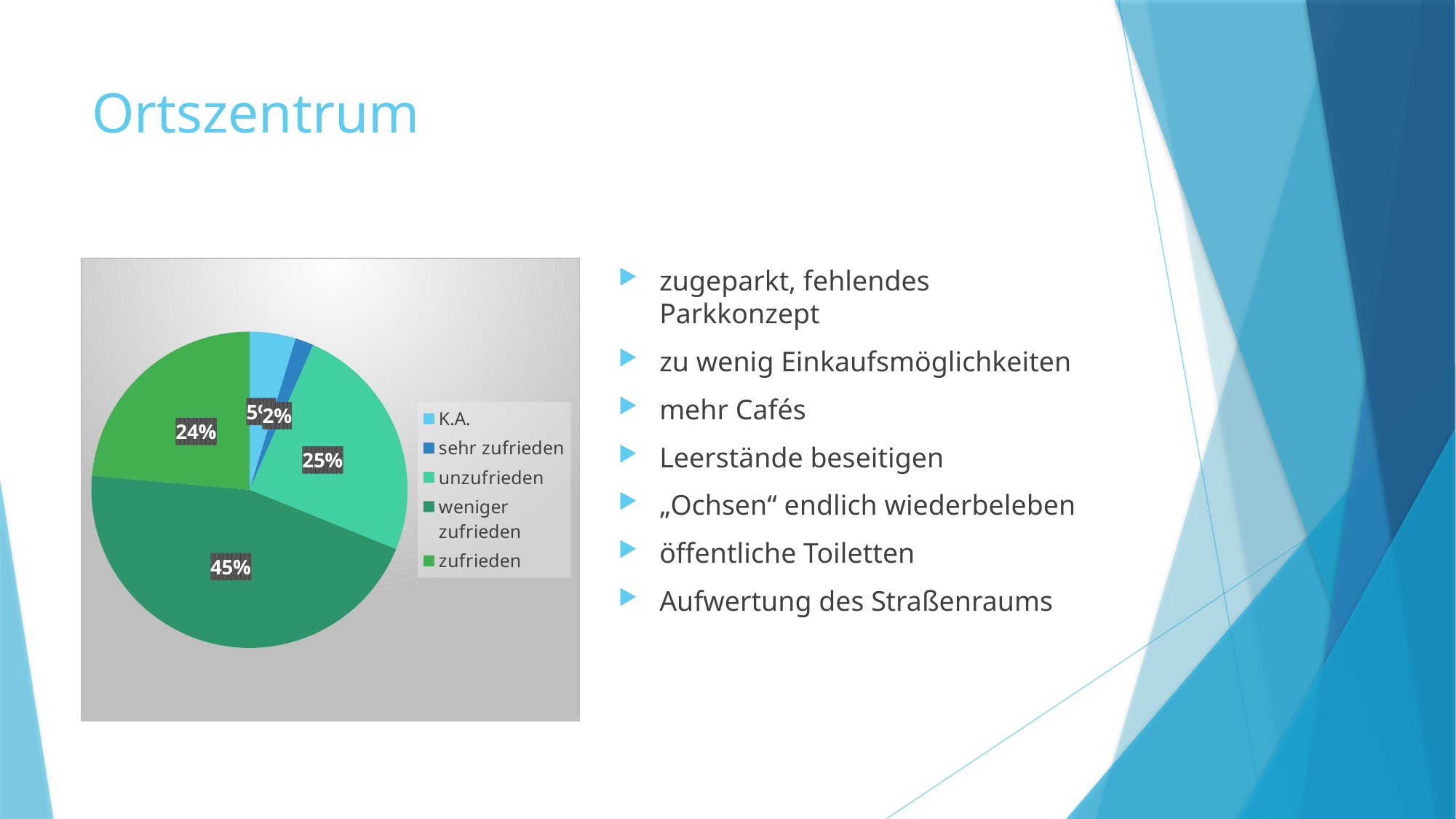
Which slice is larger, "unzufrieden" or "zufrieden"? unzufrieden What kind of chart is shown on the slide? pie chart By how many percentage points does "weniger zufrieden" exceed "zufrieden"? 21 percentage points Which category has the largest slice of the pie? weniger zufrieden What share of the pie is labelled "zufrieden"? 24% What share of the pie is labelled "unzufrieden"? 25% Which category has the smallest slice of the pie? sehr zufrieden Which legend entry is shown in the lightest blue colour? K.A. How many categories does the pie chart show? 5 What share of the pie is labelled "sehr zufrieden"? 2% What is the combined share of "unzufrieden" and "weniger zufrieden"? 70% What share of the pie is labelled "weniger zufrieden"? 45%